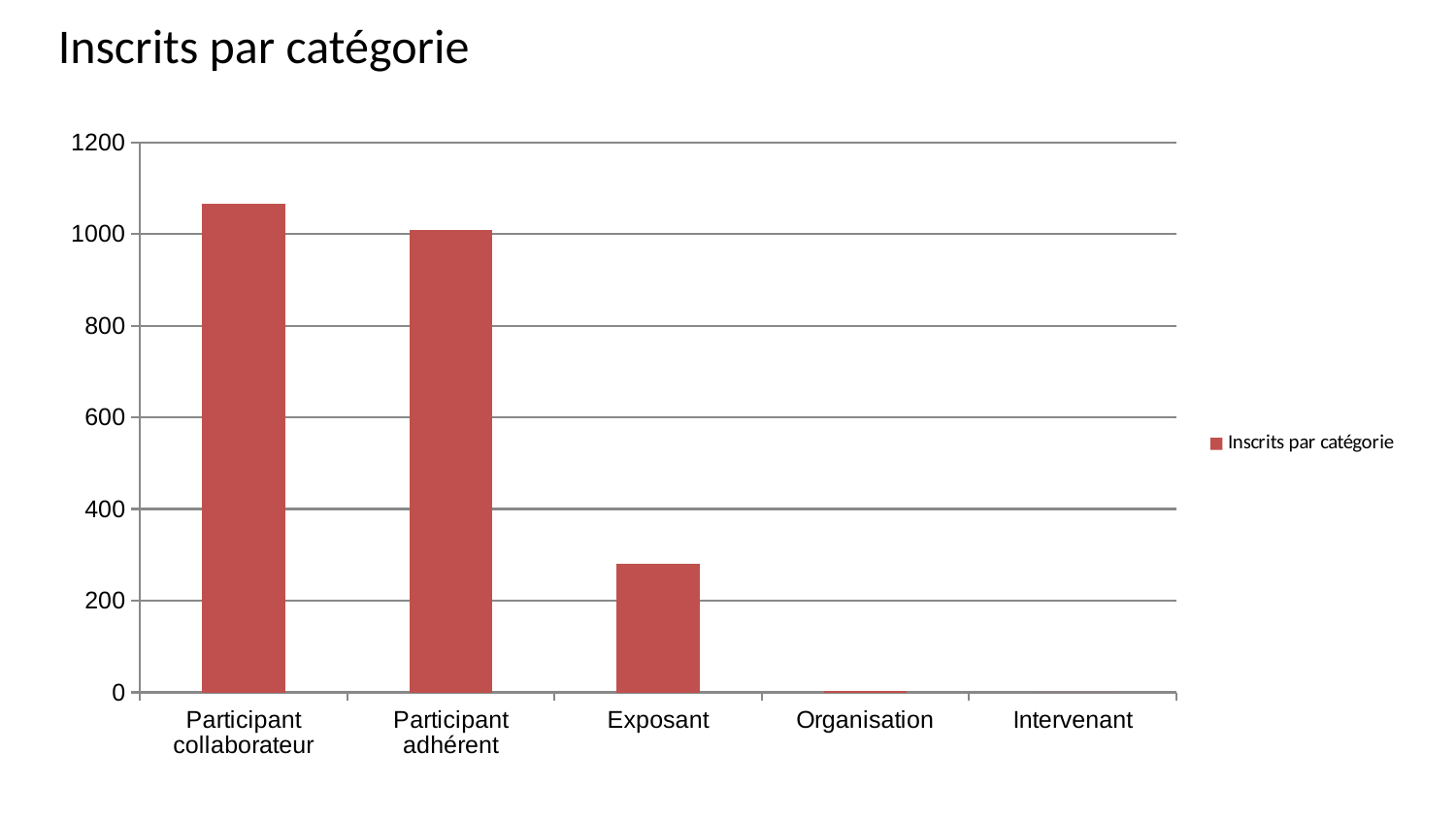
Is the value for Participant collaborateur greater or less than 1000? greater What kind of chart is shown on the slide? bar chart Is the value for Participant adhérent greater or less than 800? greater Is the value for Organisation greater or less than 200? less How many categories are shown on the x axis? 5 What is the title of the chart? Inscrits par catégorie How many series does the legend list? 1 Do the values rise or fall from left to right along the x axis? fall Which is larger, the value for Participant adhérent or the value for Exposant? Participant adhérent Which category has the highest value? Participant collaborateur